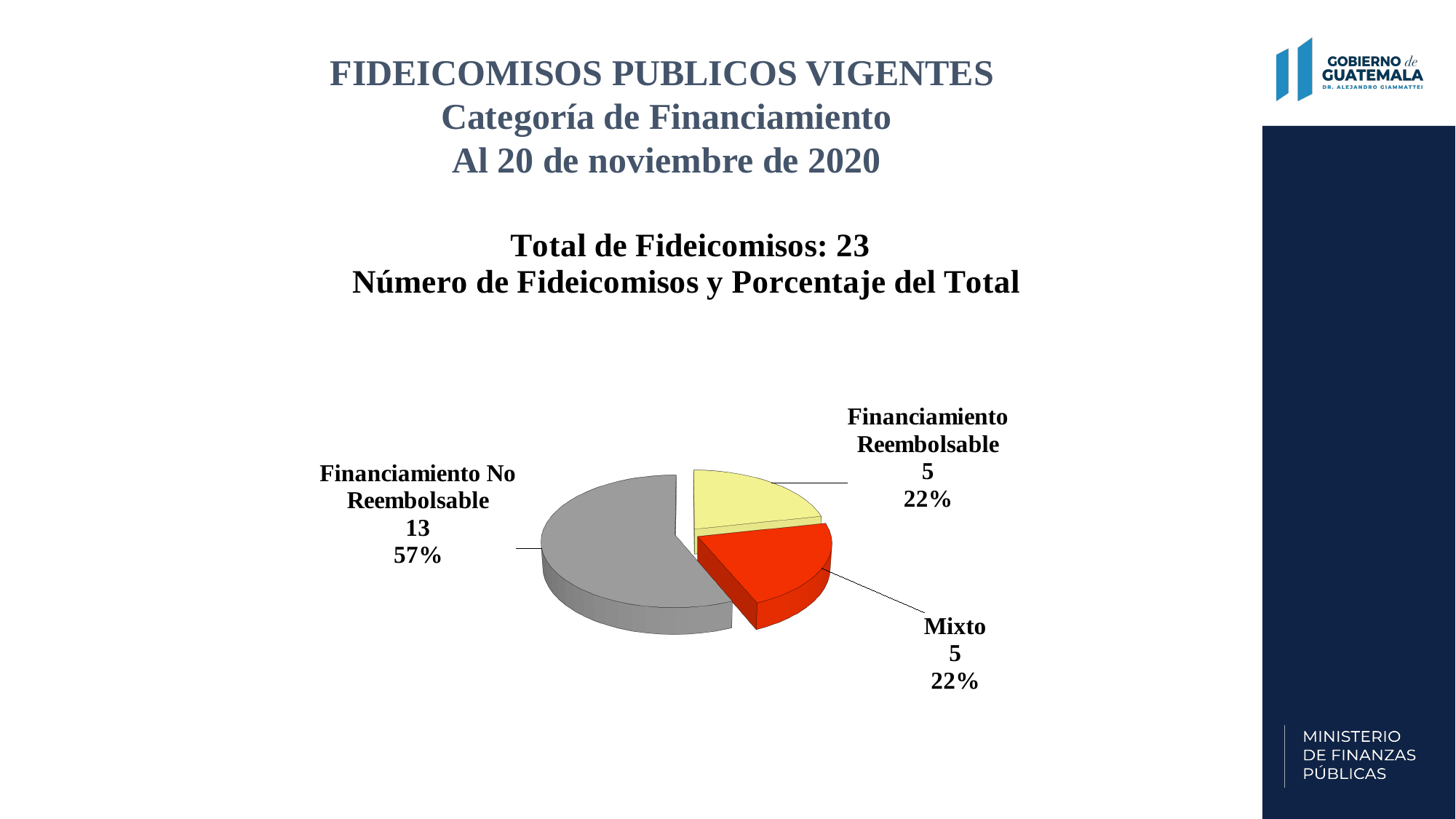
Which is larger: the number of fideicomisos for Financiamiento No Reembolsable or for Financiamiento Reembolsable? Financiamiento No Reembolsable What kind of chart is shown on the slide? Pie chart What percentage of the total does Mixto represent? 22% How many fideicomisos are in the Mixto category? 5 What percentage of the total does Financiamiento No Reembolsable represent? 57% What colour is the Mixto slice of the pie chart? Red How many fideicomisos are in the Financiamiento No Reembolsable category? 13 What is the total number of fideicomisos stated on the slide? 23 How many categories are shown in the pie chart? 3 How many fideicomisos are in the Financiamiento Reembolsable category? 5 Which category has the largest number of fideicomisos? Financiamiento No Reembolsable What is the difference in the number of fideicomisos between Financiamiento No Reembolsable and Mixto? 8